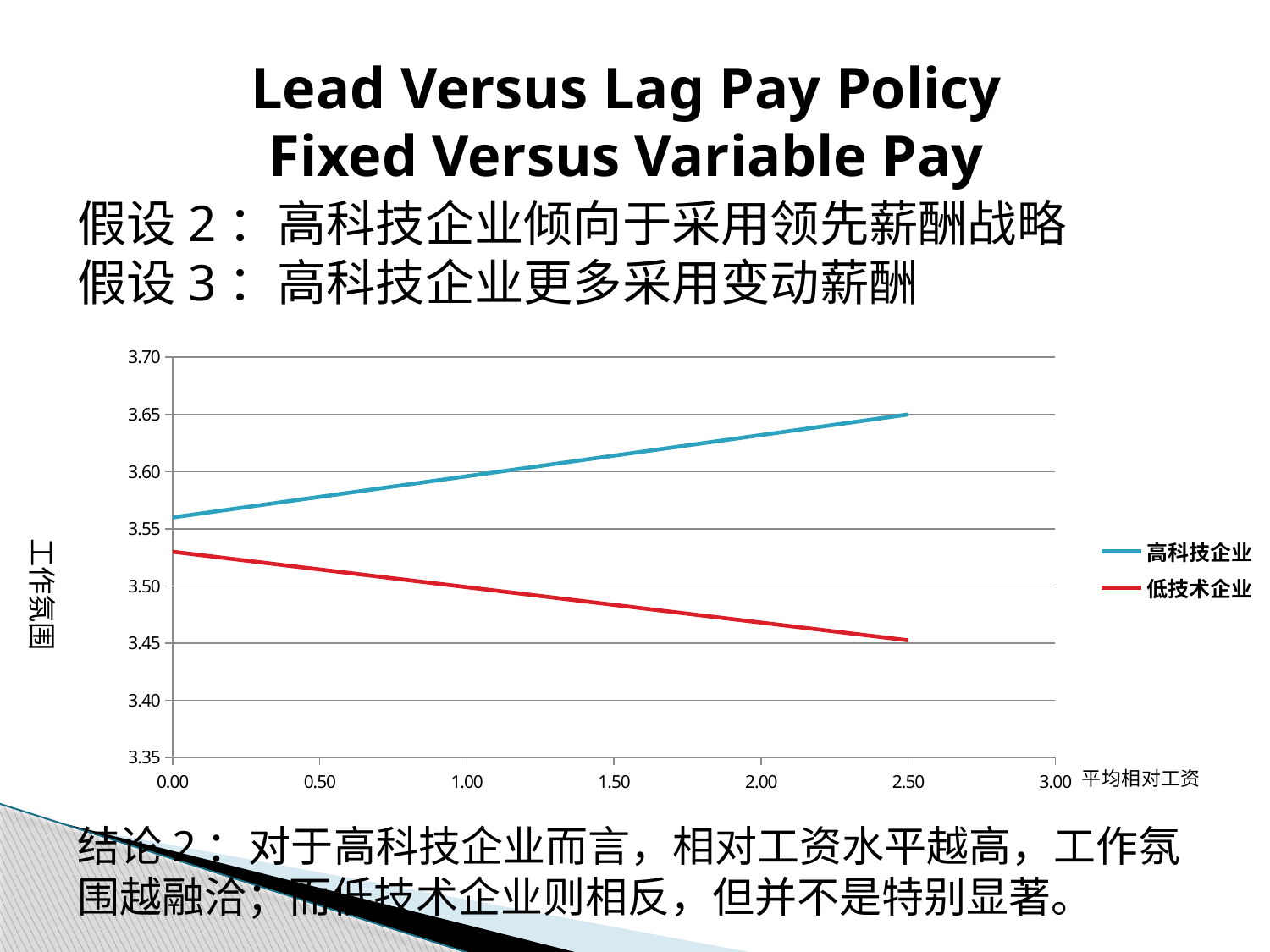
Is the value for 高科技企业 at 0.00 greater or less than 3.50? greater Is the value for 低技术企业 at 0.00 greater or less than 3.50? greater Is the value for 低技术企业 at 2.50 greater or less than 3.50? less At 2.50 on the x axis, which series has the higher value, 高科技企业 or 低技术企业? 高科技企业 Does the 高科技企业 line rise or fall as 平均相对工资 increases? rises What kind of chart is shown on the slide? line chart How many series does the legend list? 2 What colour is the 高科技企业 line in the legend? blue At 0.00 on the x axis, which series has the higher value, 高科技企业 or 低技术企业? 高科技企业 What is the label on the vertical axis of the chart? 工作氛围 Does the 低技术企业 line rise or fall as 平均相对工资 increases? falls